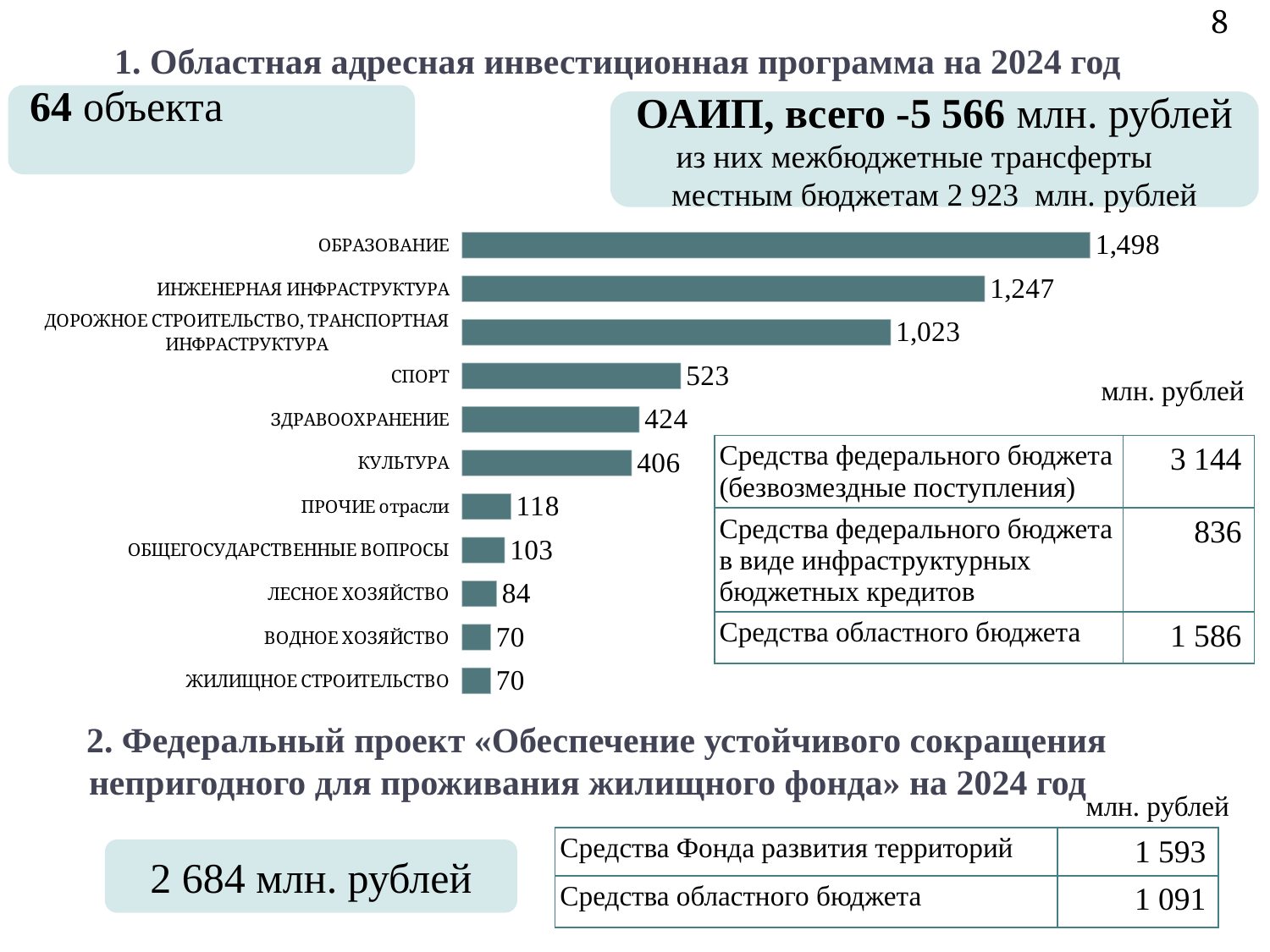
Which is larger in the bar chart: ПРОЧИЕ отрасли or ОБЩЕГОСУДАРСТВЕННЫЕ ВОПРОСЫ? ПРОЧИЕ отрасли What is the value for КУЛЬТУРА in the bar chart? 406 What kind of chart is shown on the slide? bar chart What is the value for СПОРТ in the bar chart? 523 What is the value for ОБРАЗОВАНИЕ in the bar chart? 1,498 How many categories are shown in the bar chart? 11 Which category has the highest value in the bar chart? ОБРАЗОВАНИЕ Which is larger in the bar chart: ЗДРАВООХРАНЕНИЕ or КУЛЬТУРА? ЗДРАВООХРАНЕНИЕ What is the value for ДОРОЖНОЕ СТРОИТЕЛЬСТВО, ТРАНСПОРТНАЯ ИНФРАСТРУКТУРА in the bar chart? 1,023 What is the difference between the values for СПОРТ and ЗДРАВООХРАНЕНИЕ? 99 What is the value for ЛЕСНОЕ ХОЗЯЙСТВО in the bar chart? 84 What is the difference between the values for ОБРАЗОВАНИЕ and ИНЖЕНЕРНАЯ ИНФРАСТРУКТУРА? 251